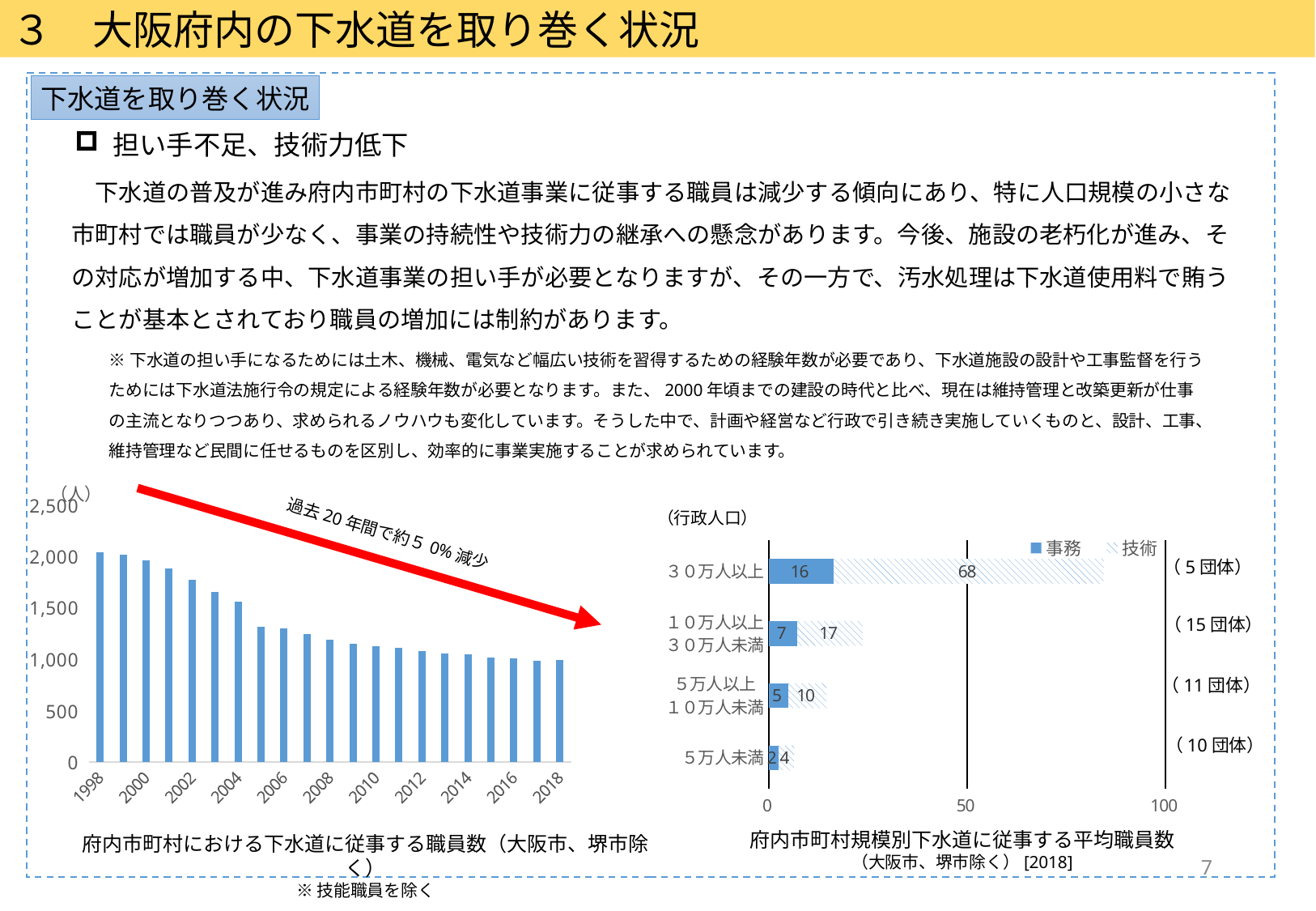
In the left chart (府内市町村における下水道に従事する職員数), is the value for 2010 greater or less than 1,000? greater In the right chart (府内市町村規模別下水道に従事する平均職員数), what is the total of the stacked bar for 5万人以上10万人未満? 15 In the left chart (府内市町村における下水道に従事する職員数), is the value for 2006 greater or less than 1,500? less In the right chart (府内市町村規模別下水道に従事する平均職員数), what is the 技術 value for 10万人以上30万人未満? 17 What kind of chart is the left chart (府内市町村における下水道に従事する職員数)? Bar chart In the right chart (府内市町村規模別下水道に従事する平均職員数), what is the difference between the 技術 and 事務 values for 30万人以上? 52 In the right chart (府内市町村規模別下水道に従事する平均職員数), which population category has the highest total average staff? 30万人以上 In the right chart (府内市町村規模別下水道に従事する平均職員数), what is the total of the stacked bar for 5万人未満? 6 In the left chart (府内市町村における下水道に従事する職員数), do the values rise or fall from 1998 to 2018? Fall In the right chart (府内市町村規模別下水道に従事する平均職員数), what is the 技術 value for 30万人以上? 68 In the right chart (府内市町村規模別下水道に従事する平均職員数), what is the 事務 value for 30万人以上? 16 In the right chart (府内市町村規模別下水道に従事する平均職員数), how many series does the legend list? 2